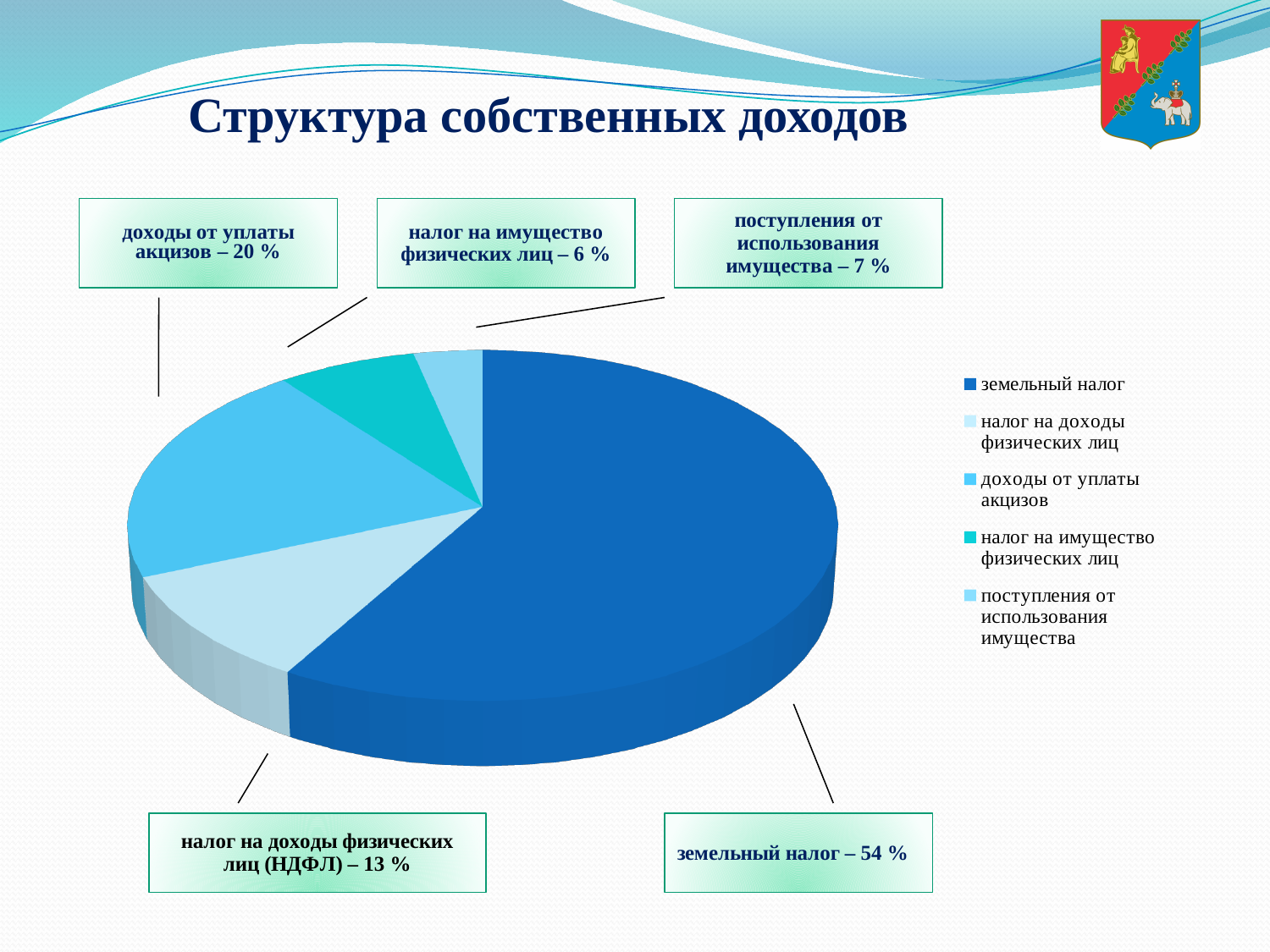
What share of own revenues comes from налог на доходы физических лиц (НДФЛ)? 13 % What share of own revenues does земельный налог account for? 54 % What share of own revenues comes from поступления от использования имущества? 7 % Which is larger: the share of НДФЛ or the share of доходы от уплаты акцизов? доходы от уплаты акцизов Which category has the smallest share of own revenues? налог на имущество физических лиц What is the difference in percentage points between земельный налог and доходы от уплаты акцизов? 34 What kind of chart is shown on the slide? pie chart What is the title of the chart on the slide? Структура собственных доходов Which category has the largest share of own revenues? земельный налог What share of own revenues comes from налог на имущество физических лиц? 6 % What share of own revenues comes from доходы от уплаты акцизов? 20 % How many categories are shown in the pie chart? 5